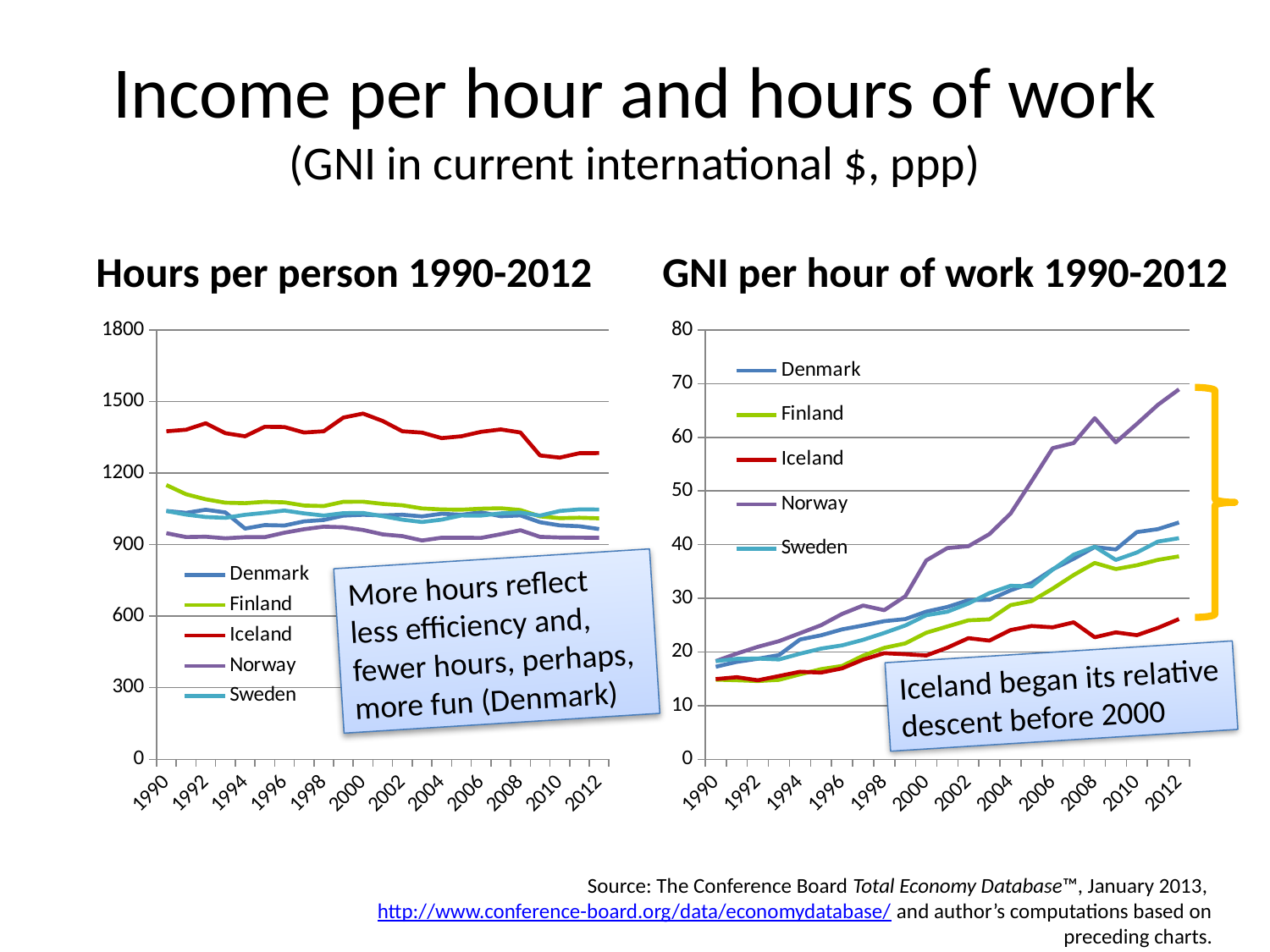
What kind of chart is the 'GNI per hour of work 1990-2012' chart? line chart In the 'GNI per hour of work 1990-2012' chart, which country has the lowest value in 2012? Iceland In the 'GNI per hour of work 1990-2012' chart, which country has the highest value in 2012? Norway In the 'GNI per hour of work 1990-2012' chart, is the value for Norway in 2012 greater or less than 60? greater What kind of chart is the 'Hours per person 1990-2012' chart? line chart In the 'Hours per person 1990-2012' chart, is the value for Iceland in 2012 greater or less than 1200? greater How many series does the legend of the 'Hours per person 1990-2012' chart list? 5 In the 'Hours per person 1990-2012' chart, which country has the highest hours per person across the period? Iceland In the 'GNI per hour of work 1990-2012' chart, does the Norway line rise or fall from 1990 to 2012? rise In the 'Hours per person 1990-2012' chart, does the Iceland line rise or fall from 1990 to 2012? fall In the 'Hours per person 1990-2012' chart, is the value for Norway in 2012 greater or less than 1200? less In the 'GNI per hour of work 1990-2012' chart, which countries are listed in the legend? Denmark, Finland, Iceland, Norway, Sweden